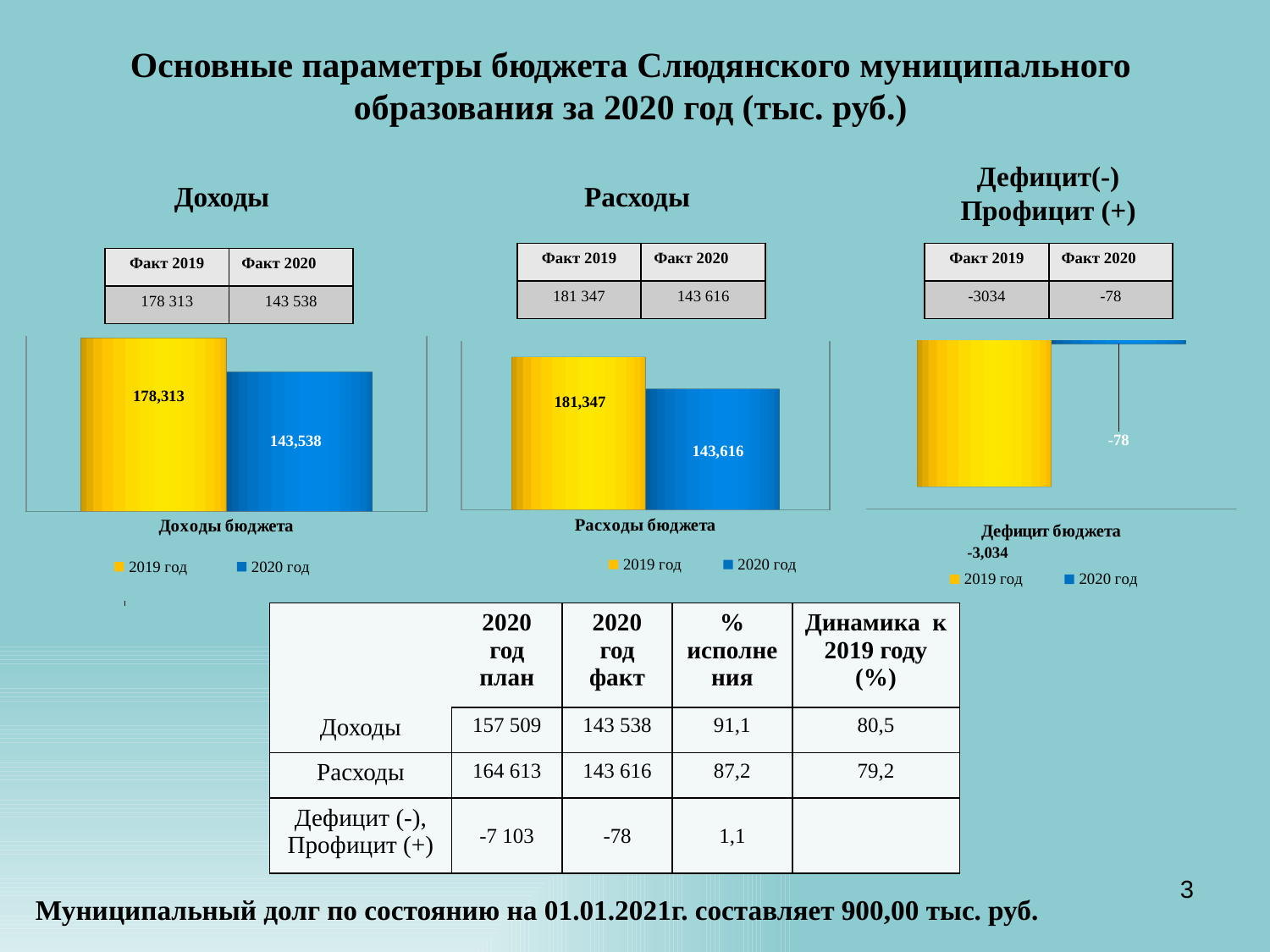
In the Расходы бюджета chart, which colour represents 2020 год? Blue In the Доходы бюджета chart, what is the value for 2020 год? 143,538 In the Расходы бюджета chart, what is the value for 2020 год? 143,616 In the Доходы бюджета chart, which year has the higher value? 2019 год In the Дефицит бюджета chart, what is the value for 2019 год? -3,034 How many series does the legend of the Расходы бюджета chart list? 2 In the Доходы бюджета chart, what is the value for 2019 год? 178,313 In the Дефицит бюджета chart, what is the value for 2020 год? -78 In the Доходы бюджета chart, what is the difference between the 2019 год and 2020 год values? 34,775 What type of chart is the Доходы бюджета chart? Bar chart In the Расходы бюджета chart, what is the value for 2019 год? 181,347 In the Расходы бюджета chart, what is the difference between the 2019 год and 2020 год values? 37,731